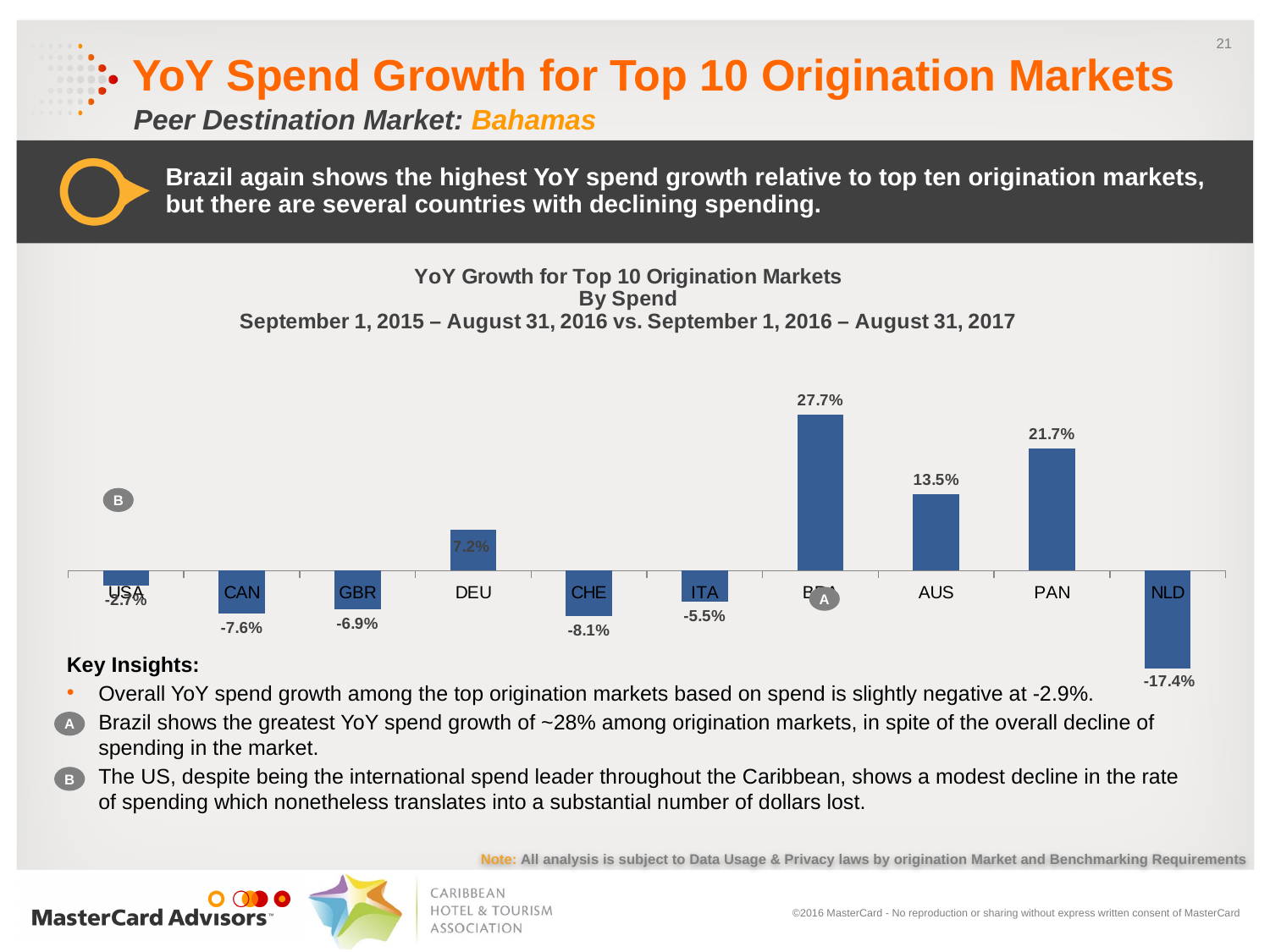
What is the YoY spend growth value shown for PAN? 21.7% What is the first line of the chart's title? YoY Growth for Top 10 Origination Markets What is the YoY spend growth value shown for NLD? -17.4% What type of chart is used on this slide? Bar chart What is the difference between the values for PAN and AUS? 8.2 percentage points Which has the larger YoY spend growth value, CAN or GBR? GBR How many origination markets are plotted in the chart? 10 What is the YoY spend growth value shown for CHE? -8.1% Which origination market has the lowest YoY spend growth in the chart? NLD What is the YoY spend growth value shown for DEU? 7.2% What is the YoY spend growth value shown for USA? -2.7% Which origination market has the highest YoY spend growth in the chart? BRA